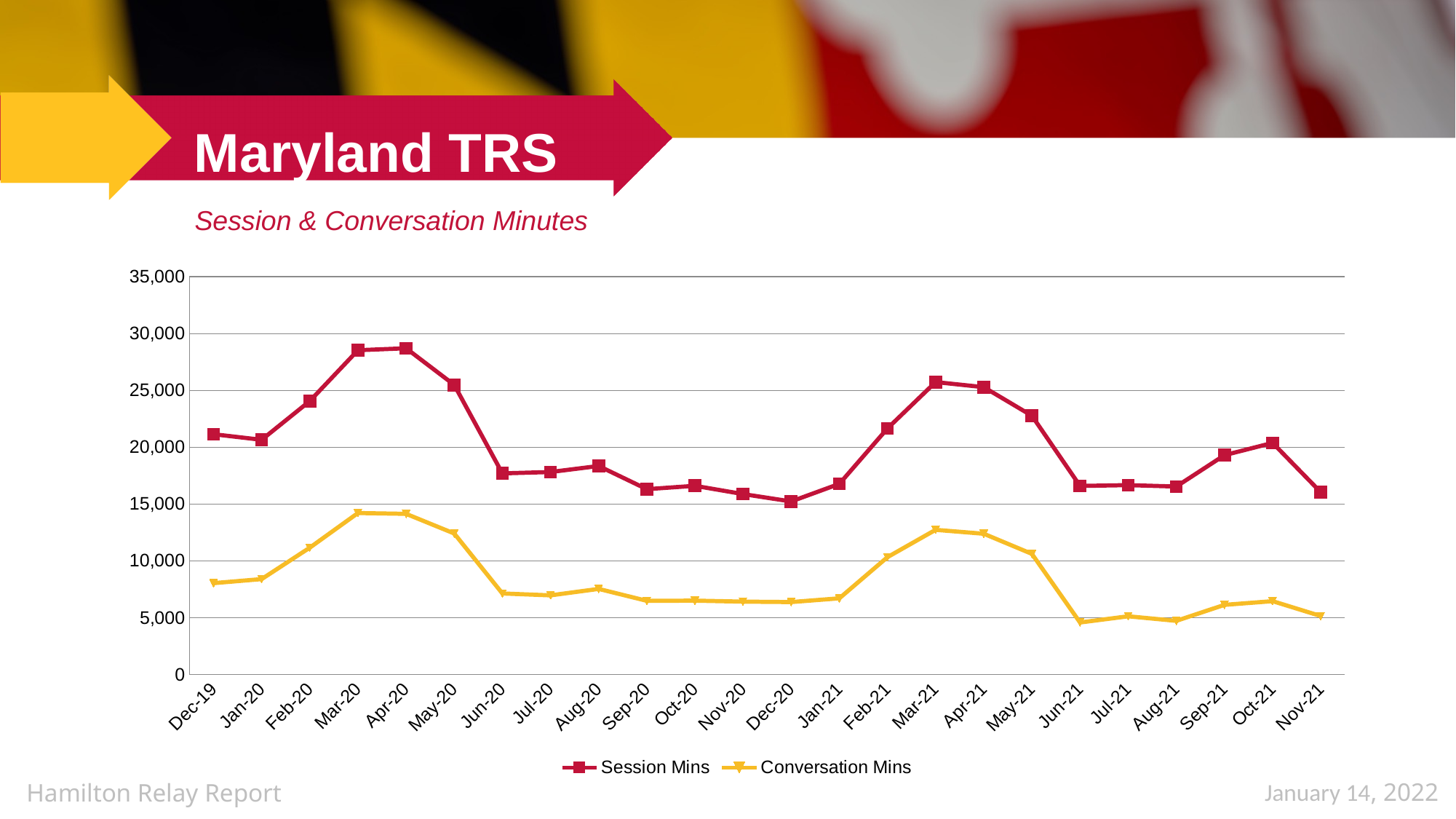
What is the subtitle of the chart? Session & Conversation Minutes Which is larger, the Session Mins value for Mar-20 or for Jun-20? Mar-20 What kind of chart is shown on the slide? Line chart Is the Conversation Mins value for Mar-21 greater or less than 10,000? greater Do Session Mins rise or fall from Mar-21 to Jun-21? fall How many months are plotted along the x axis? 24 Is the Session Mins value for Dec-20 greater or less than 20,000? less Do Session Mins rise or fall from Dec-20 to Mar-21? rise How many series does the legend list? 2 Is the Conversation Mins value for Jun-20 greater or less than 10,000? less Which is larger, the Conversation Mins value for Mar-21 or for Jun-21? Mar-21